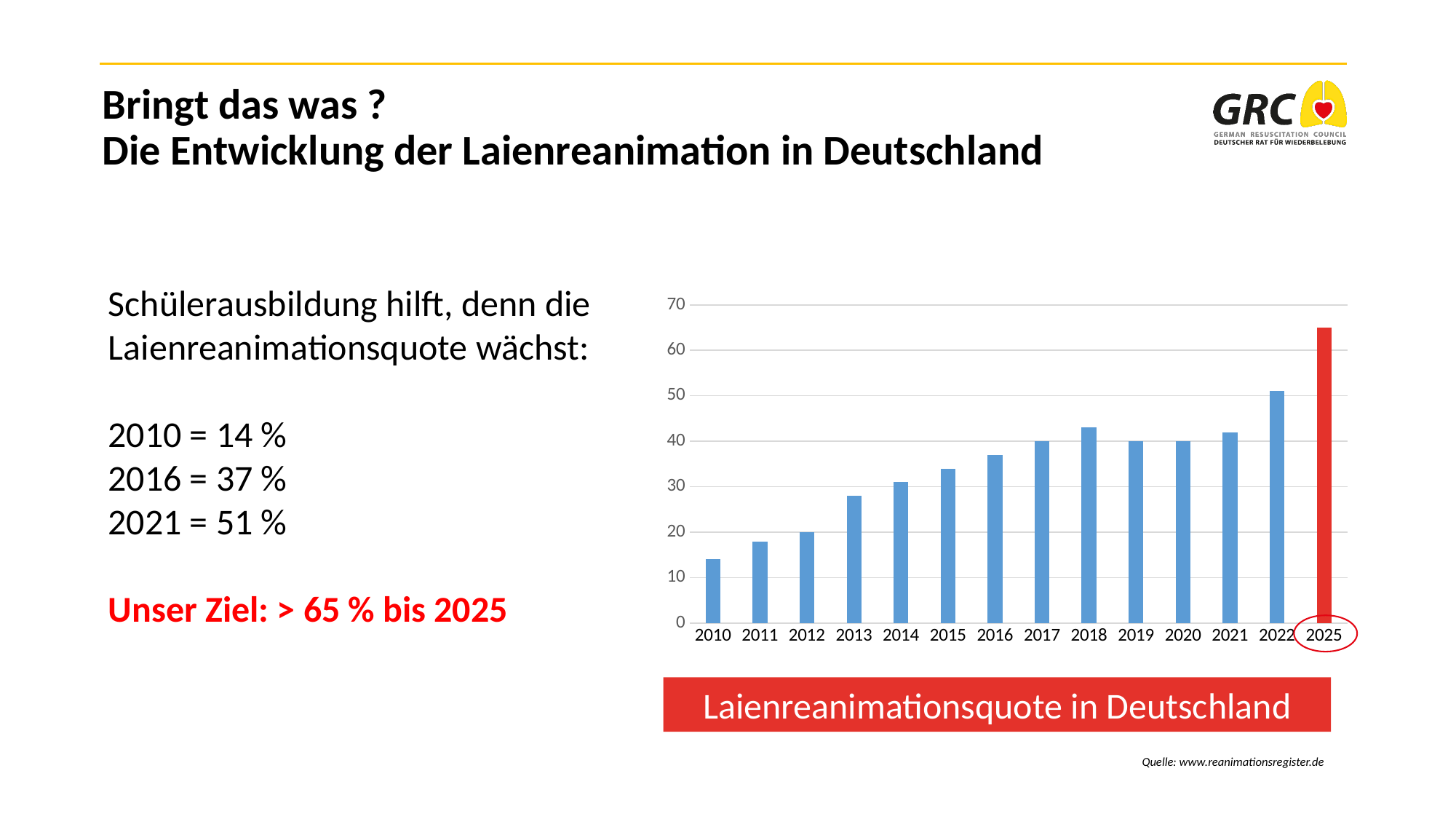
What is the title shown below the chart? Laienreanimationsquote in Deutschland What type of chart is shown on the slide? bar chart How many bars (years) are plotted in the chart? 14 Which year has the highest bar in the chart? 2025 Do the values generally rise or fall from 2010 to 2025? rise Which year has the larger value, 2022 or 2018? 2022 Is the value for 2013 greater or less than 30? less What is the Laienreanimationsquote for 2010 according to the slide? 14 % Which year has the lowest bar in the chart? 2010 Is the value for 2025 greater or less than 60? greater What is the Laienreanimationsquote for 2021 according to the slide? 51 % By how many percentage points did the Laienreanimationsquote increase from 2010 to 2021? 37 %